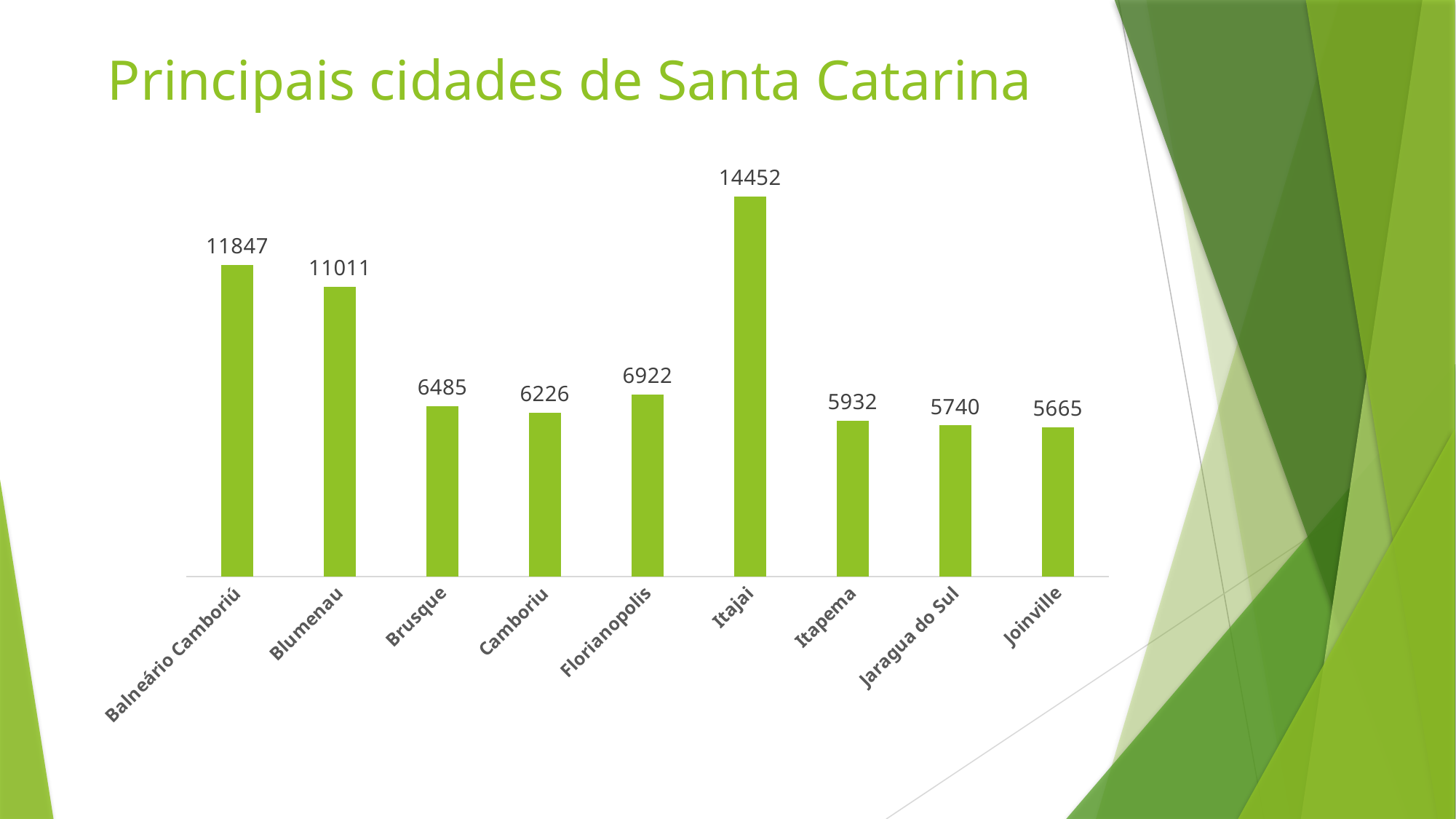
What is the title of the slide? Principais cidades de Santa Catarina What is the value for Blumenau? 11011 Which is larger, the value for Brusque or the value for Itapema? Brusque Which city has the highest value? Itajai What is the difference between the values for Florianopolis and Camboriu? 696 Which city has the lowest value? Joinville What kind of chart is shown on the slide? Bar chart What is the value for Jaragua do Sul? 5740 What is the difference between the values for Itajai and Balneário Camboriú? 2605 How many cities are shown in the chart? 9 What colour are the bars in the chart? Green What is the value for Itajai? 14452